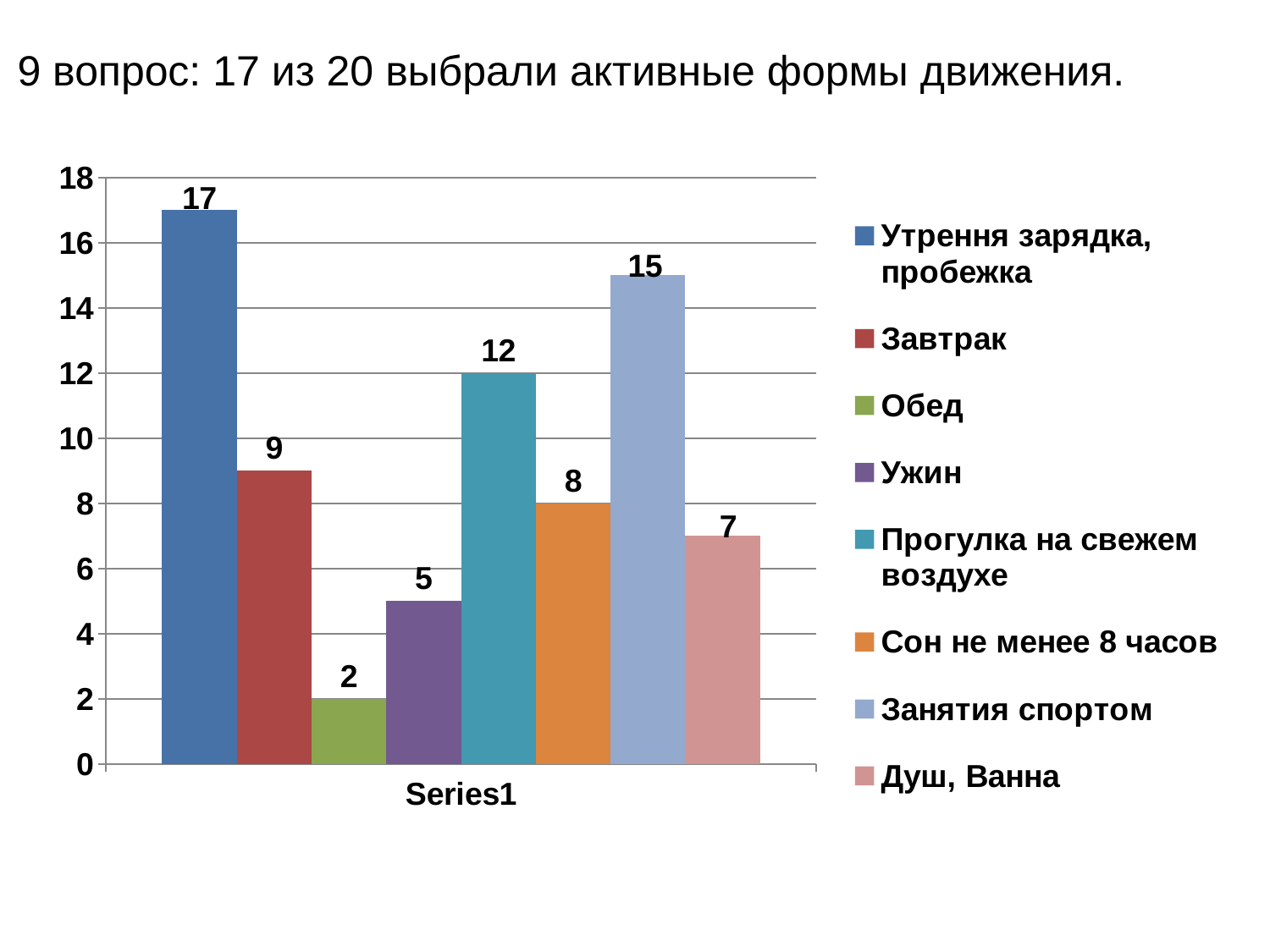
What is the value for Сон не менее 8 часов? 8 What is the value for Прогулка на свежем воздухе? 12 What is the value for Утрення зарядка, пробежка? 17 What kind of chart is shown on the slide? bar chart Which is larger, the value for Ужин or the value for Душ, Ванна? Душ, Ванна How many bars are shown in the chart? 8 Is the value for Занятия спортом greater or less than 14? greater What is the difference between the values for Занятия спортом and Завтрак? 6 What is the value for Душ, Ванна? 7 Which category has the lowest value? Обед What is the label shown on the x axis below the bars? Series1 Which category has the highest value? Утрення зарядка, пробежка